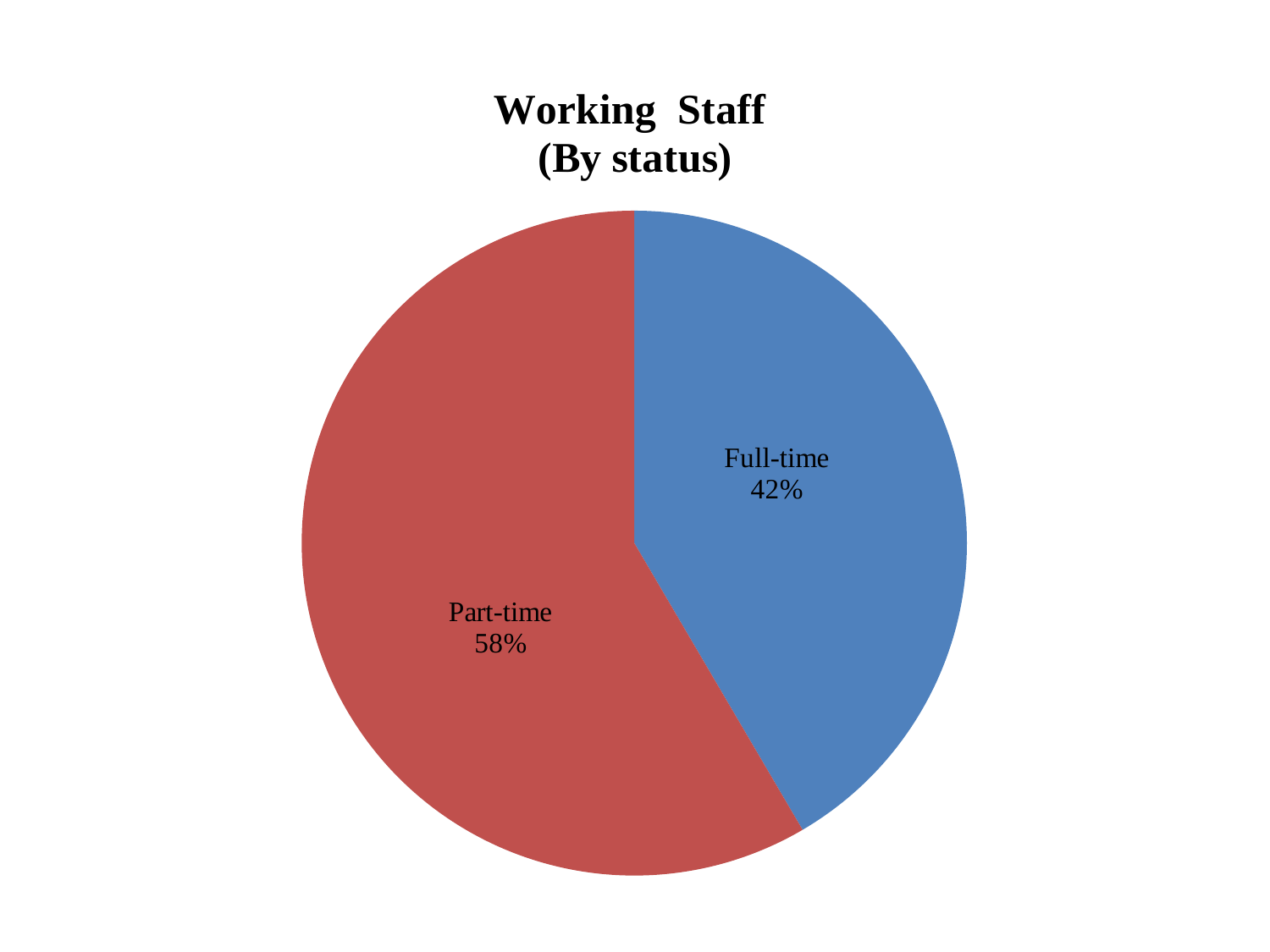
Which status has the smallest share of working staff? Full-time What is the difference in percentage points between the Part-time and Full-time shares? 16 What percentage of working staff is Part-time? 58% Which status has the largest share of working staff? Part-time What share of the pie does the Part-time slice represent? 58% What kind of chart is shown on the slide? Pie chart What percentage of working staff is Full-time? 42% What colour is the Full-time slice? Blue How many slices does the pie chart have? 2 What is the title of the chart? Working Staff (By status) Which is larger, the Full-time share or the Part-time share? Part-time